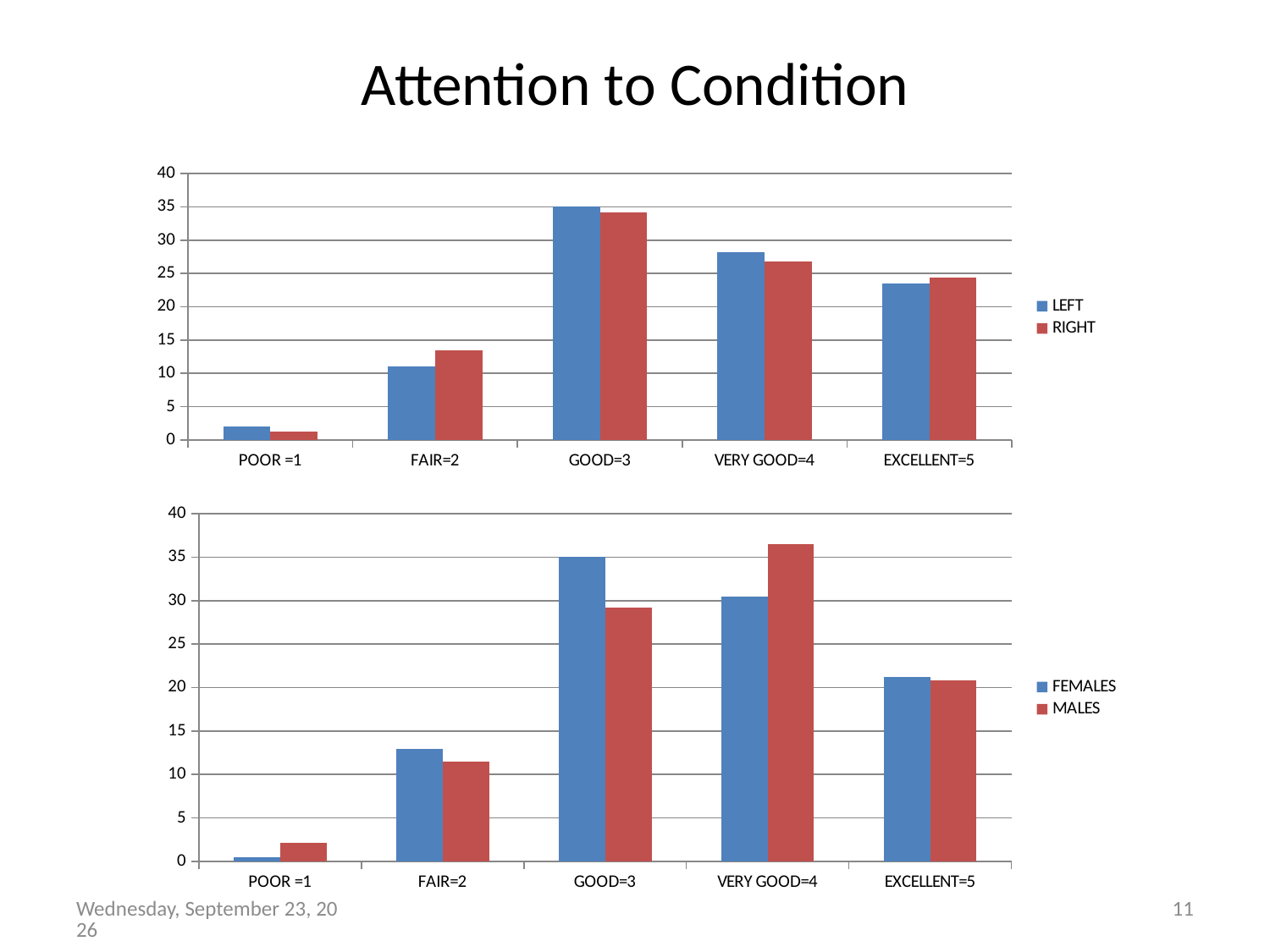
On the top chart, which category has the highest LEFT value? GOOD=3 On the top chart, which category has the lowest RIGHT value? POOR =1 On the top chart, is the LEFT value for GOOD=3 greater or less than 30? greater On the bottom chart, is the MALES value for FAIR=2 greater or less than 15? less What kind of chart is the top chart on the slide? bar chart On the bottom chart, which category has the highest MALES value? VERY GOOD=4 On the top chart, how many series does the legend list? 2 On the top chart, for FAIR=2, which is larger, LEFT or RIGHT? RIGHT On the top chart, how many categories are shown on the x axis? 5 What are the two legend entries on the bottom chart? FEMALES and MALES On the bottom chart, for GOOD=3, which is larger, FEMALES or MALES? FEMALES On the bottom chart, is the FEMALES value for VERY GOOD=4 greater or less than 25? greater